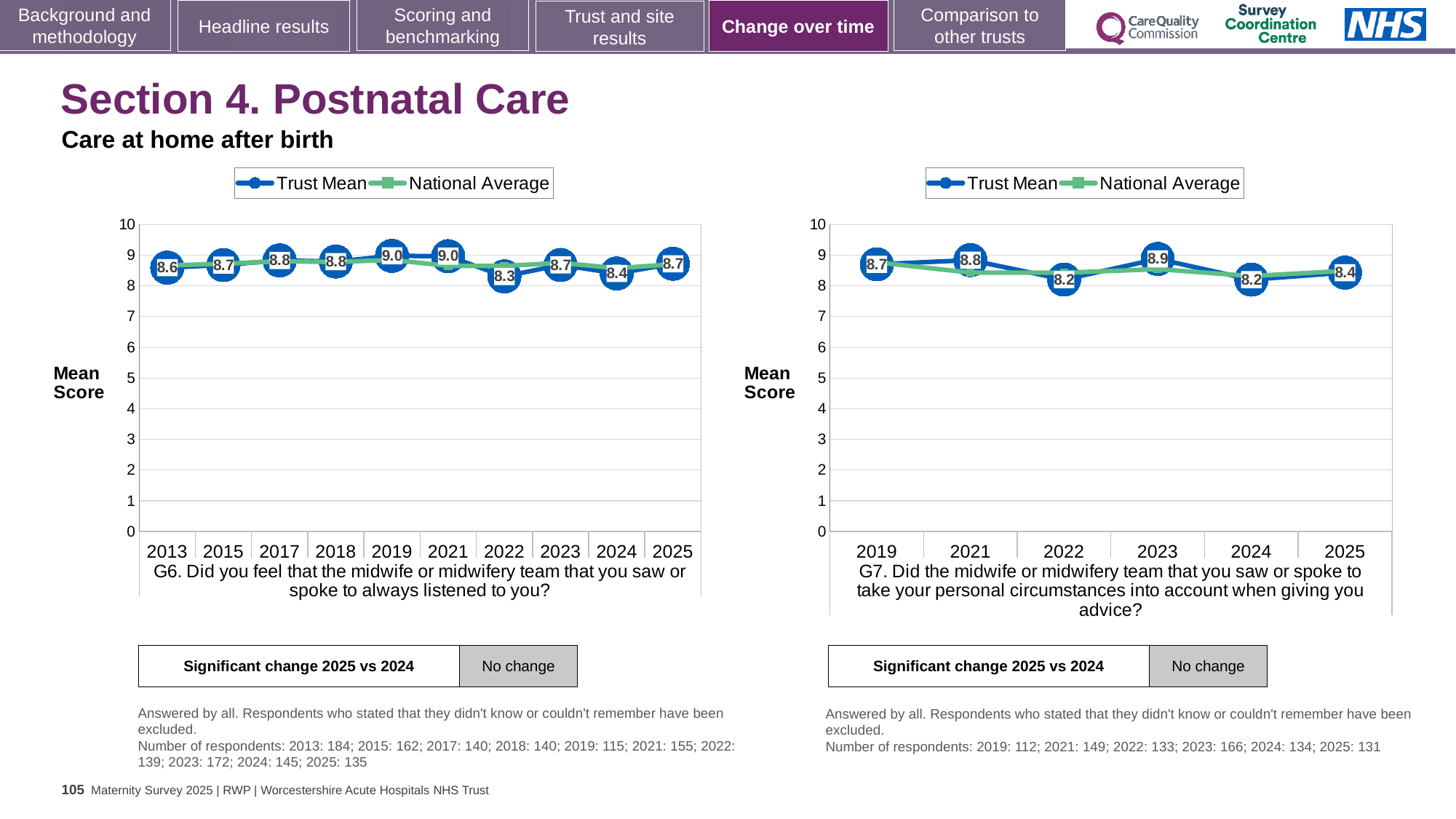
In the left chart (G6), what is the Trust Mean score for 2022? 8.3 In the left chart (G6), what is the Trust Mean score for 2025? 8.7 In the left chart (G6), which year has the lowest Trust Mean score? 2022 In the right chart (G7), how many series does the legend list? 2 In the right chart (G7), which year has the highest Trust Mean score? 2023 In the right chart (G7), is the Trust Mean score for 2021 larger or smaller than the score for 2022? larger In the right chart (G7), what is the Trust Mean score for 2023? 8.9 What kind of chart is the right chart (G7)? line chart In the left chart (G6), what is the difference between the Trust Mean scores for 2021 and 2022? 0.7 In the right chart (G7), what is the Trust Mean score for 2025? 8.4 In the right chart (G7), is the Trust Mean score for 2024 greater or less than 9? less In the left chart (G6), how many years are shown on the x axis? 10